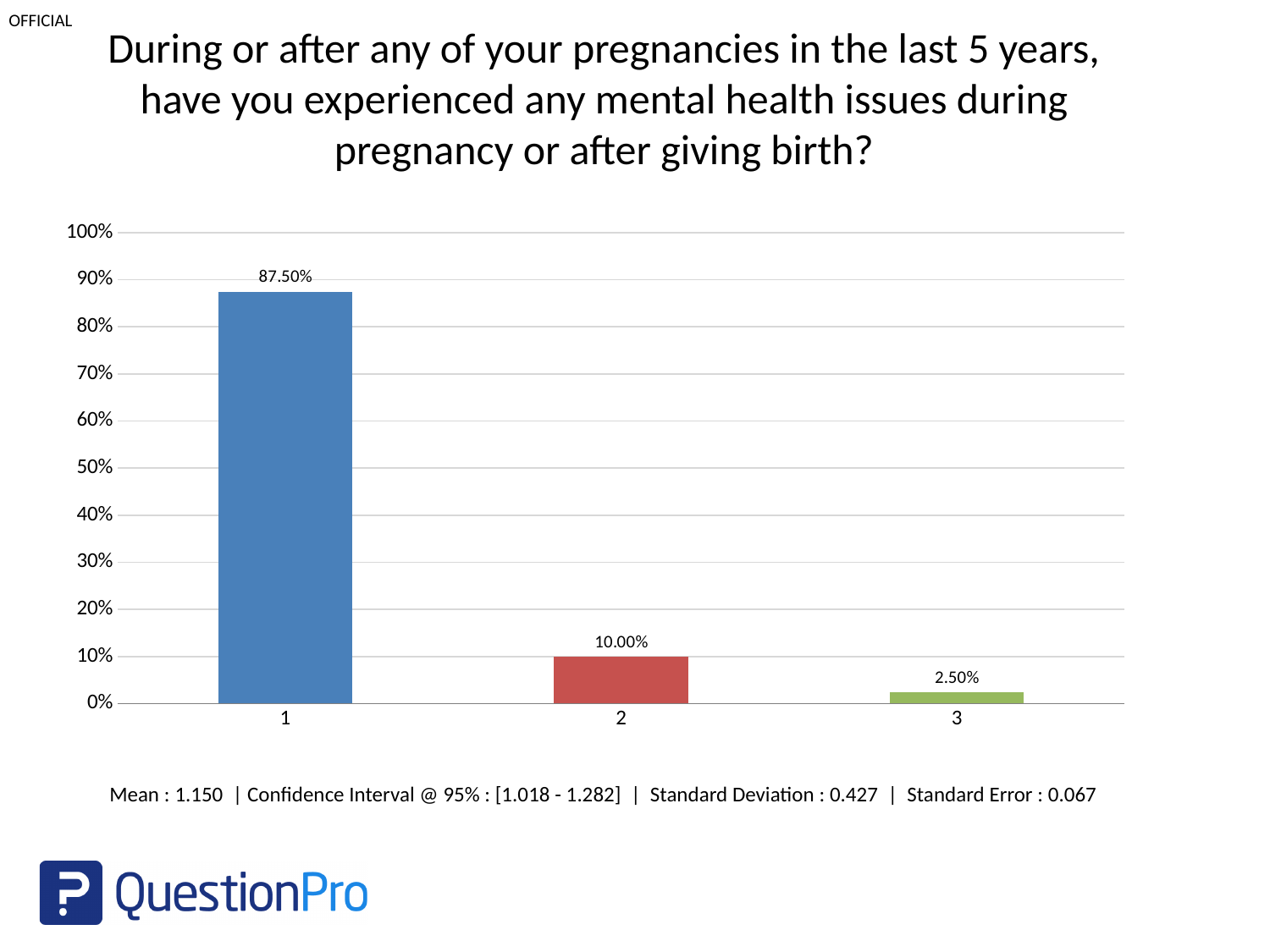
Do the values rise or fall from category 1 to category 3? fall What is the difference between the values for category 1 and category 2? 77.50% Which category has the highest value? 1 What kind of chart is shown on the slide? bar chart Which is larger, the value for category 2 or category 3? 2 What is the value for category 1? 87.50% How many categories are shown on the x axis? 3 What is the value for category 2? 10.00% Is the value for category 1 greater or less than 80%? greater What is the value for category 3? 2.50% What is the difference between the values for category 2 and category 3? 7.50% Which category has the lowest value? 3